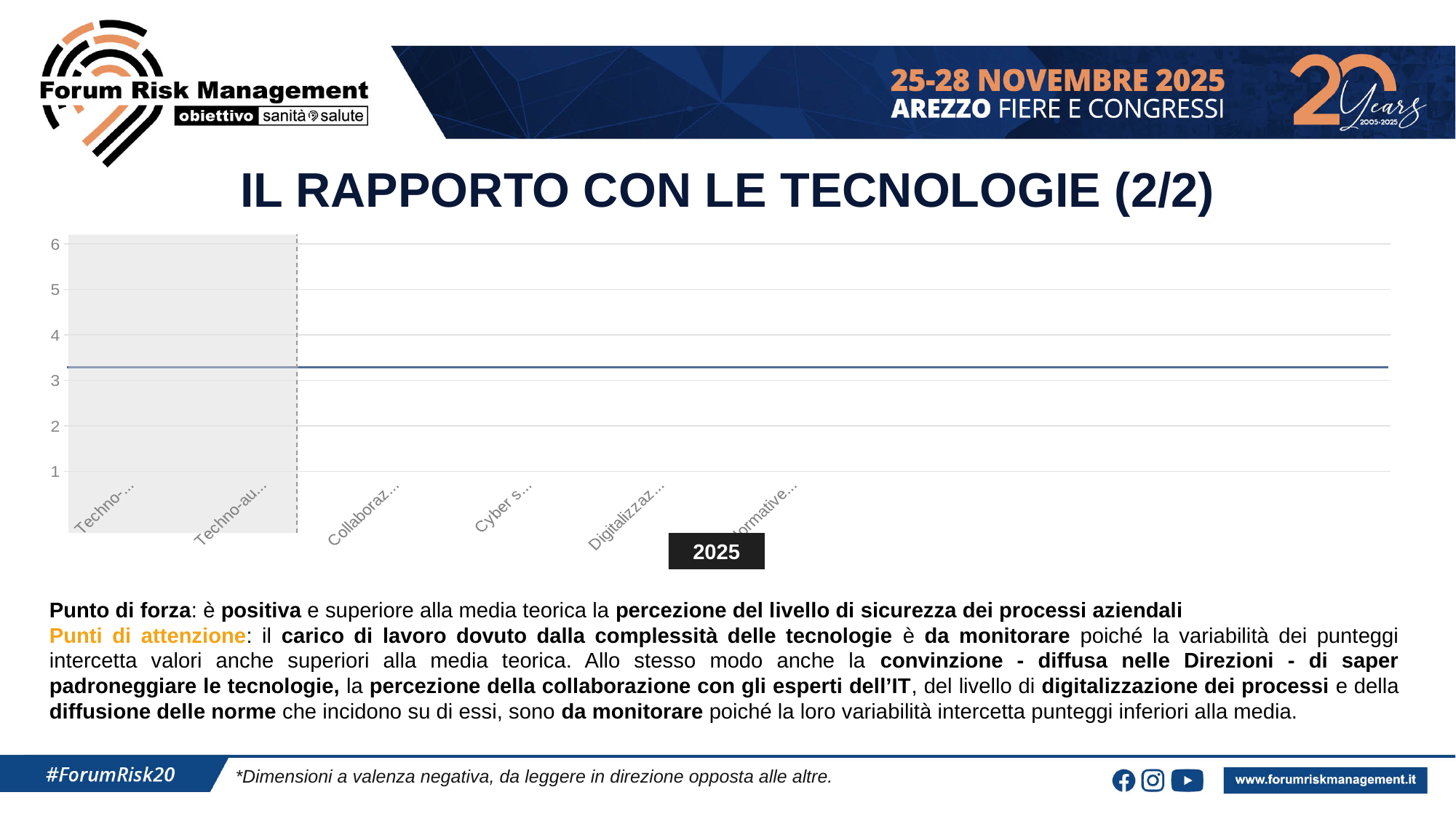
Is the horizontal reference line on the chart greater or less than 3? greater How many x-axis categories fall inside the grey shaded area on the left of the chart? 2 How many category labels are shown along the x axis of the chart? 6 Is the horizontal reference line on the chart greater or less than 4? less